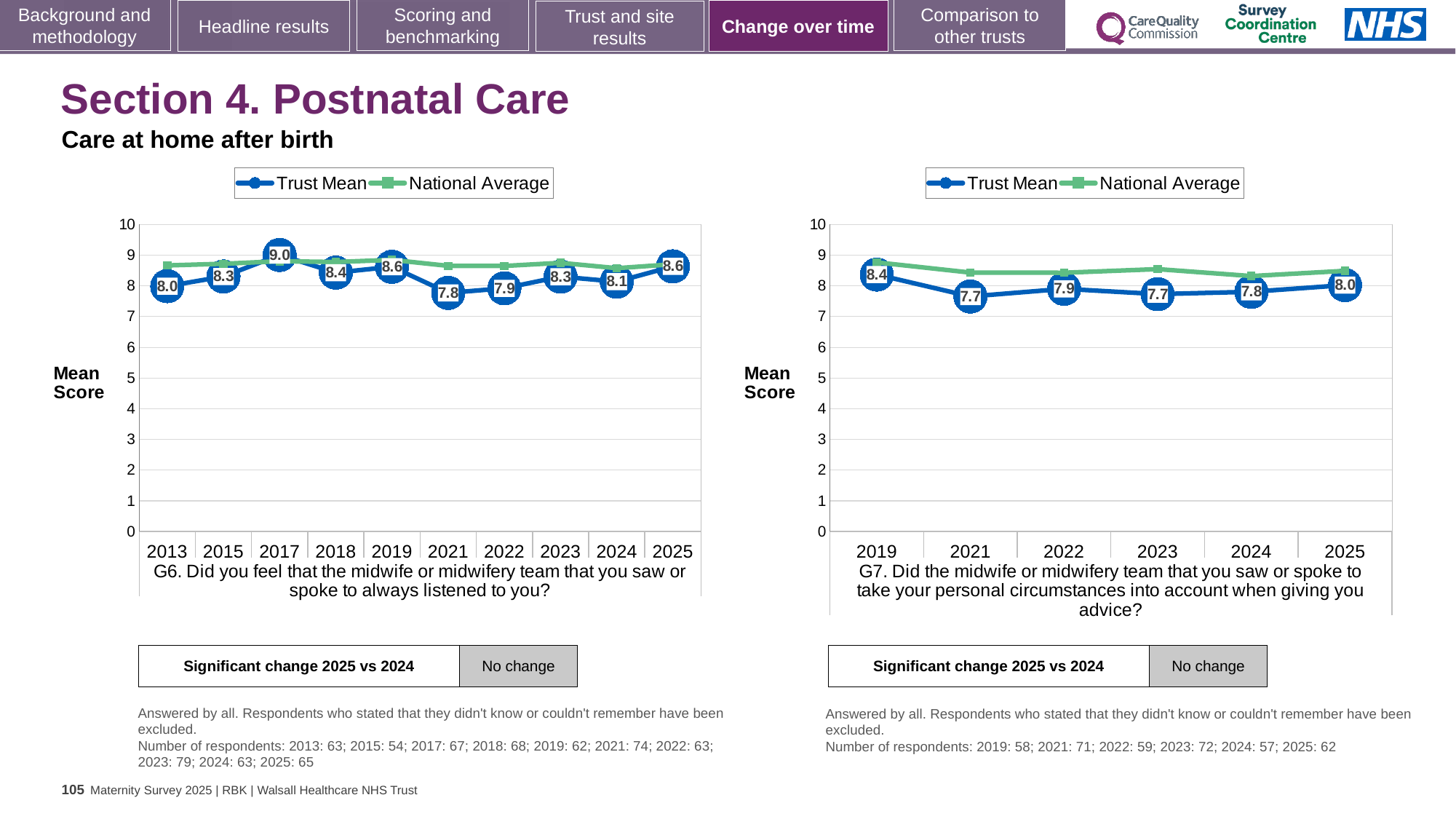
In the right chart (G7), what is the Trust Mean score for 2019? 8.4 In the left chart (G6), what is the Trust Mean score for 2017? 9.0 In the right chart (G7), is the Trust Mean score for 2022 larger or smaller than the score for 2024? larger In the left chart (G6), what is the Trust Mean score for 2025? 8.6 In the left chart (G6), which year has the highest Trust Mean score? 2017 In the right chart (G7), how many series does the legend list? 2 In the right chart (G7), which year has the highest Trust Mean score? 2019 In the left chart (G6), how many years are shown on the x axis? 10 In the left chart (G6), what is the difference between the Trust Mean scores for 2017 and 2021? 1.2 In the left chart (G6), which year has the lowest Trust Mean score? 2021 What type of chart is the left chart (G6)? Line chart In the right chart (G7), what is the Trust Mean score for 2025? 8.0